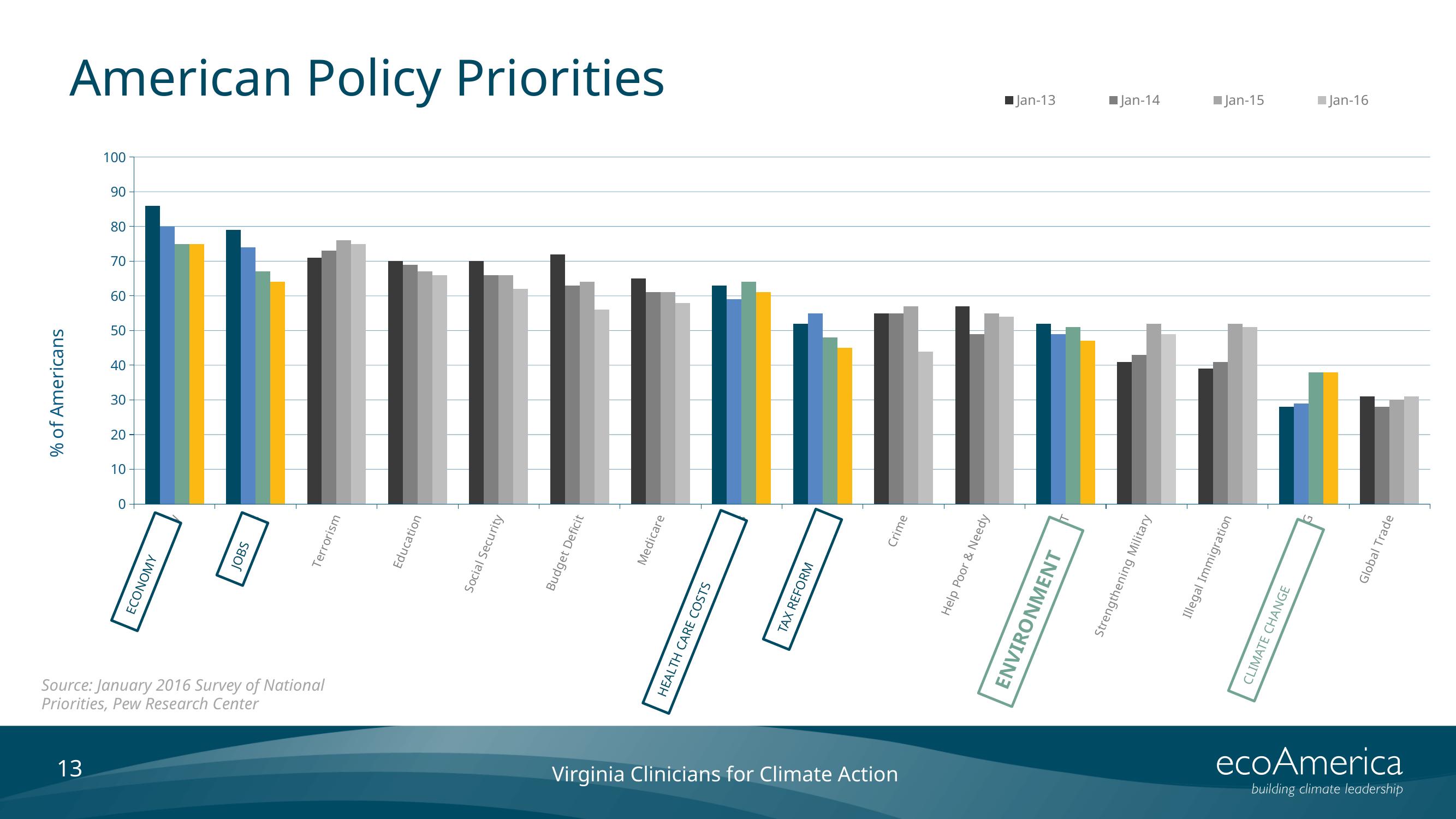
How many policy categories are shown on the x axis? 16 What is the label on the vertical axis? % of Americans Is the Jan-13 value for Help Poor & Needy greater or less than 50? greater What kind of chart is shown on the slide? bar chart Is the Jan-13 value for Economy greater or less than 80? greater Which is larger: the Jan-16 value for Terrorism or the Jan-16 value for Education? Terrorism Is the Jan-16 value for Global Trade greater or less than 40? less Do the values for Economy rise or fall from Jan-13 to Jan-16? fall How many series does the legend list? 4 Which category has the highest Jan-13 value? Economy Which is larger: the Jan-16 value for Climate Change or the Jan-16 value for Global Trade? Climate Change